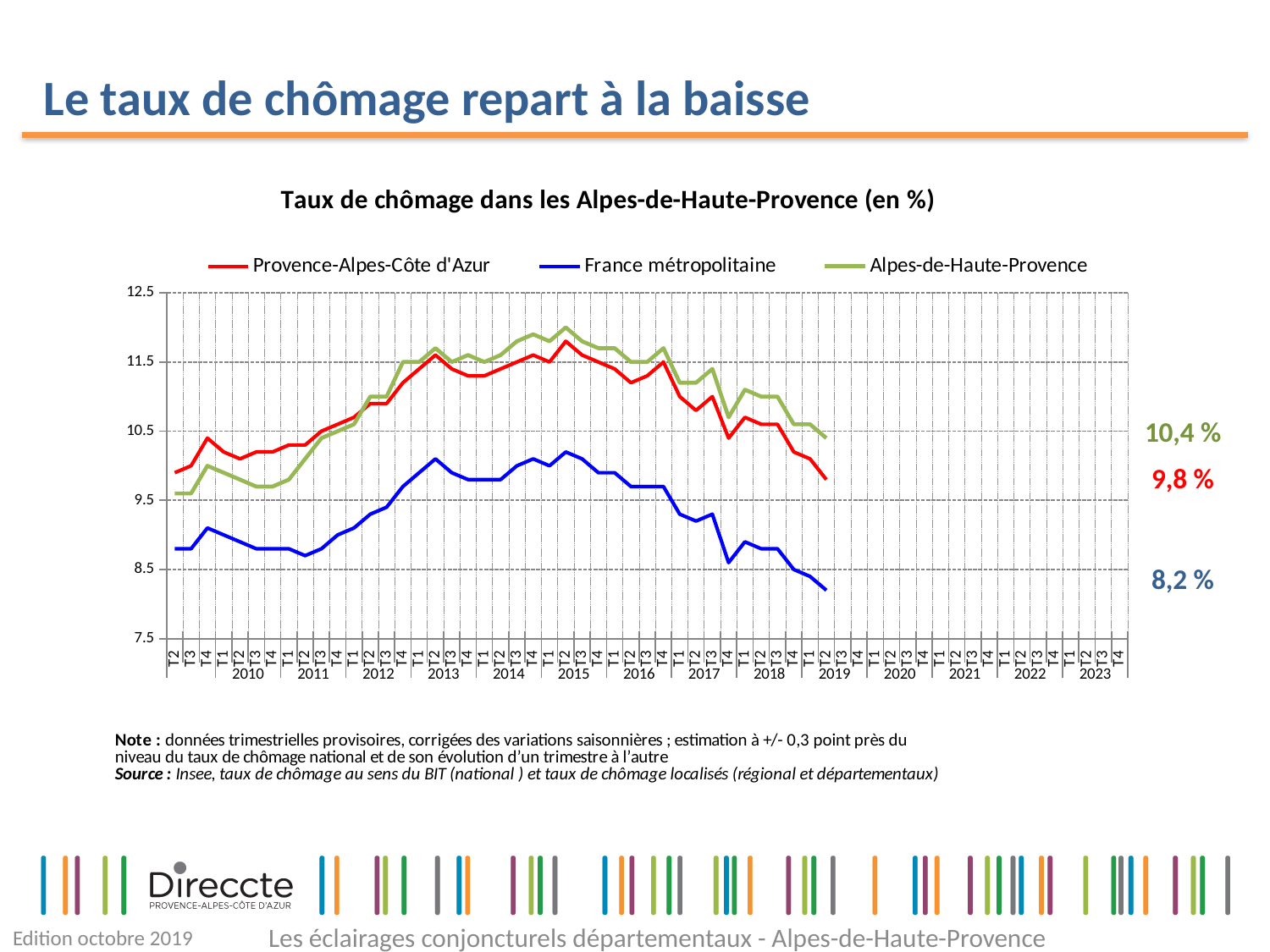
What is the latest value labelled for Alpes-de-Haute-Provence? 10,4 % Is the value for Alpes-de-Haute-Provence at T2 2015 greater or less than 11.5? greater How many series does the legend list? 3 Which series has the highest latest labelled value? Alpes-de-Haute-Provence What kind of chart is shown on the slide? line chart Is the value for France métropolitaine at T2 2013 greater or less than 10.5? less What is the difference between the latest labelled values for Alpes-de-Haute-Provence and Provence-Alpes-Côte d'Azur? 0,6 point What is the difference between the latest labelled values for Alpes-de-Haute-Provence and France métropolitaine? 2,2 points Does the France métropolitaine line rise or fall between T1 2017 and T2 2019? fall What is the latest value labelled for France métropolitaine? 8,2 % Which series has the lowest latest labelled value? France métropolitaine What is the latest value labelled for Provence-Alpes-Côte d'Azur? 9,8 %